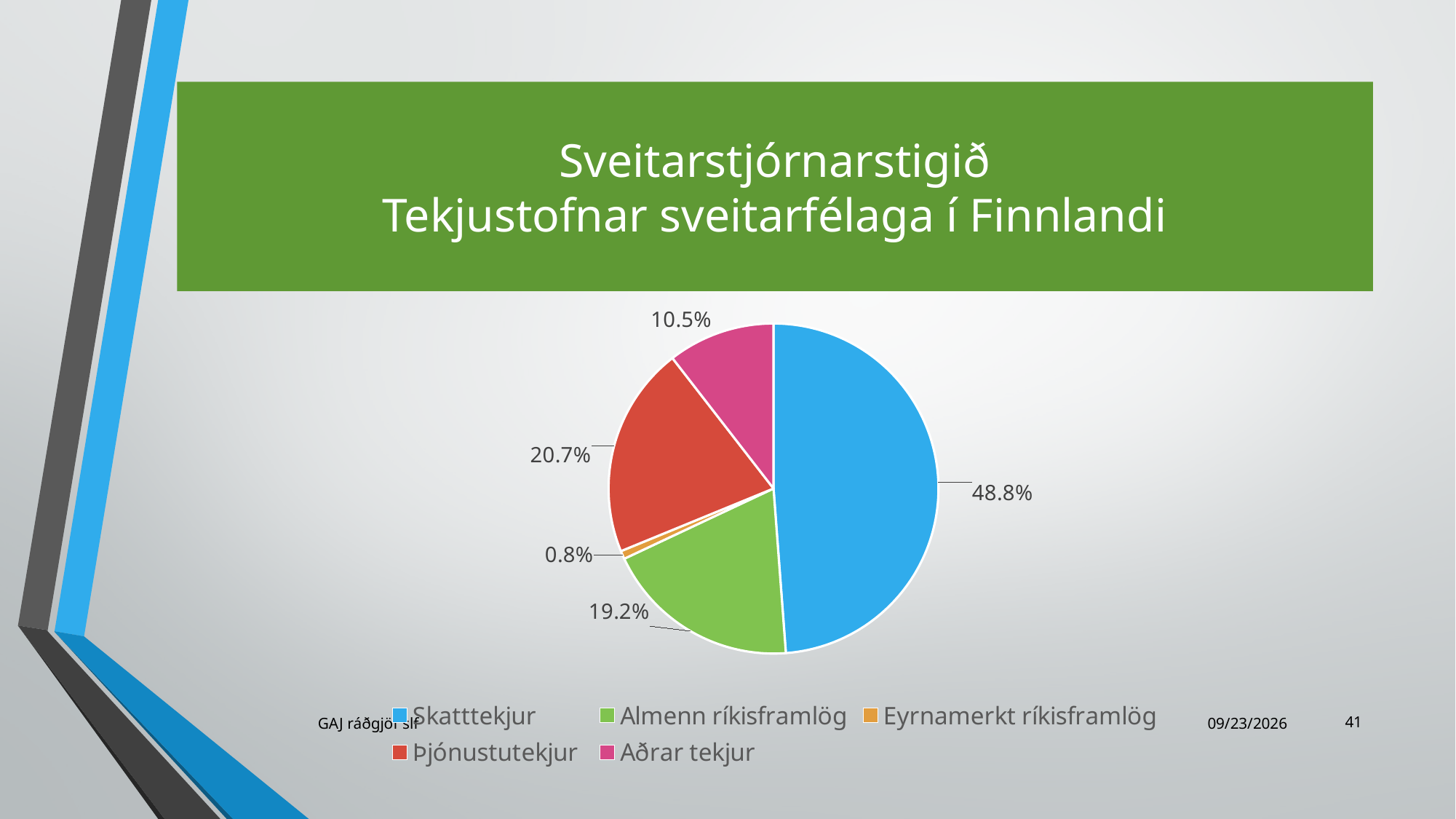
What share of the pie does Almenn ríkisframlög represent? 19.2% Which colour represents Aðrar tekjur in the legend? Pink Which is larger, the share for Þjónustutekjur or the share for Almenn ríkisframlög? Þjónustutekjur Which category has the smallest slice of the pie? Eyrnamerkt ríkisframlög What share of the pie does Þjónustutekjur represent? 20.7% What share of the pie does Eyrnamerkt ríkisframlög represent? 0.8% What kind of chart is shown on the slide? Pie chart What share of the pie does Aðrar tekjur represent? 10.5% What is the difference in percentage points between Skatttekjur and Þjónustutekjur? 28.1 What share of the pie does Skatttekjur represent? 48.8% How many slices does the pie chart have? 5 Which category has the largest slice of the pie? Skatttekjur